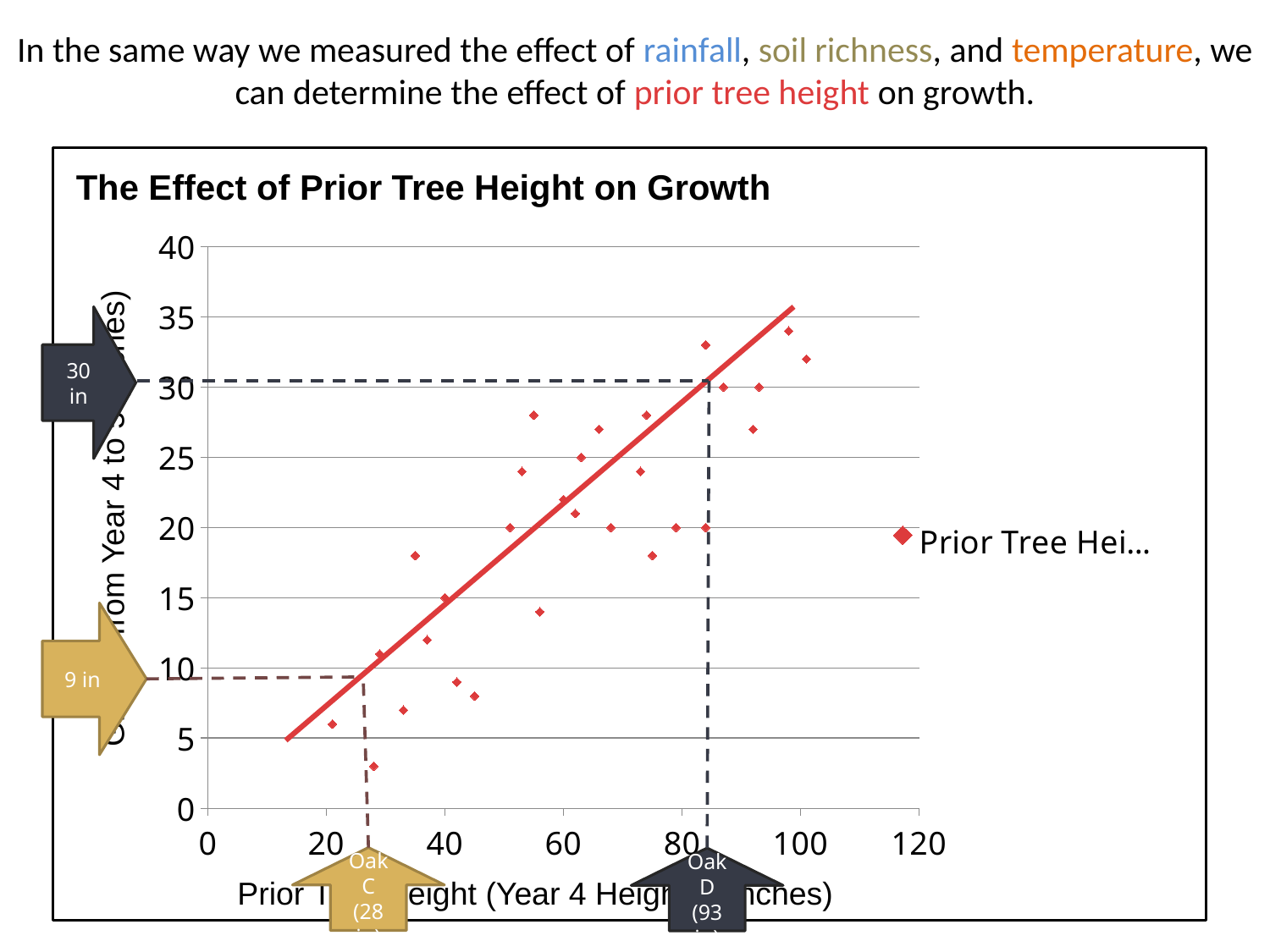
Is the growth value of the highest plotted point greater or less than 30? greater Is the growth value of the lowest plotted point greater or less than 5? less Which annotated tree has the larger predicted growth, Oak C or Oak D? Oak D What is the highest tick value shown on the x axis? 120 What kind of chart is shown on the slide? scatter chart What is the title of the chart? The Effect of Prior Tree Height on Growth According to the annotation, what growth does the trend line give for Oak D (93 in)? 30 in According to the annotation, what growth does the trend line give for Oak C (28 in)? 9 in What is the difference between the annotated growth values for Oak D and Oak C? 21 in How many series does the chart's legend list? 1 What is the highest value shown on the y axis? 40 Do the plotted growth values generally rise or fall as prior tree height increases along the x axis? rise